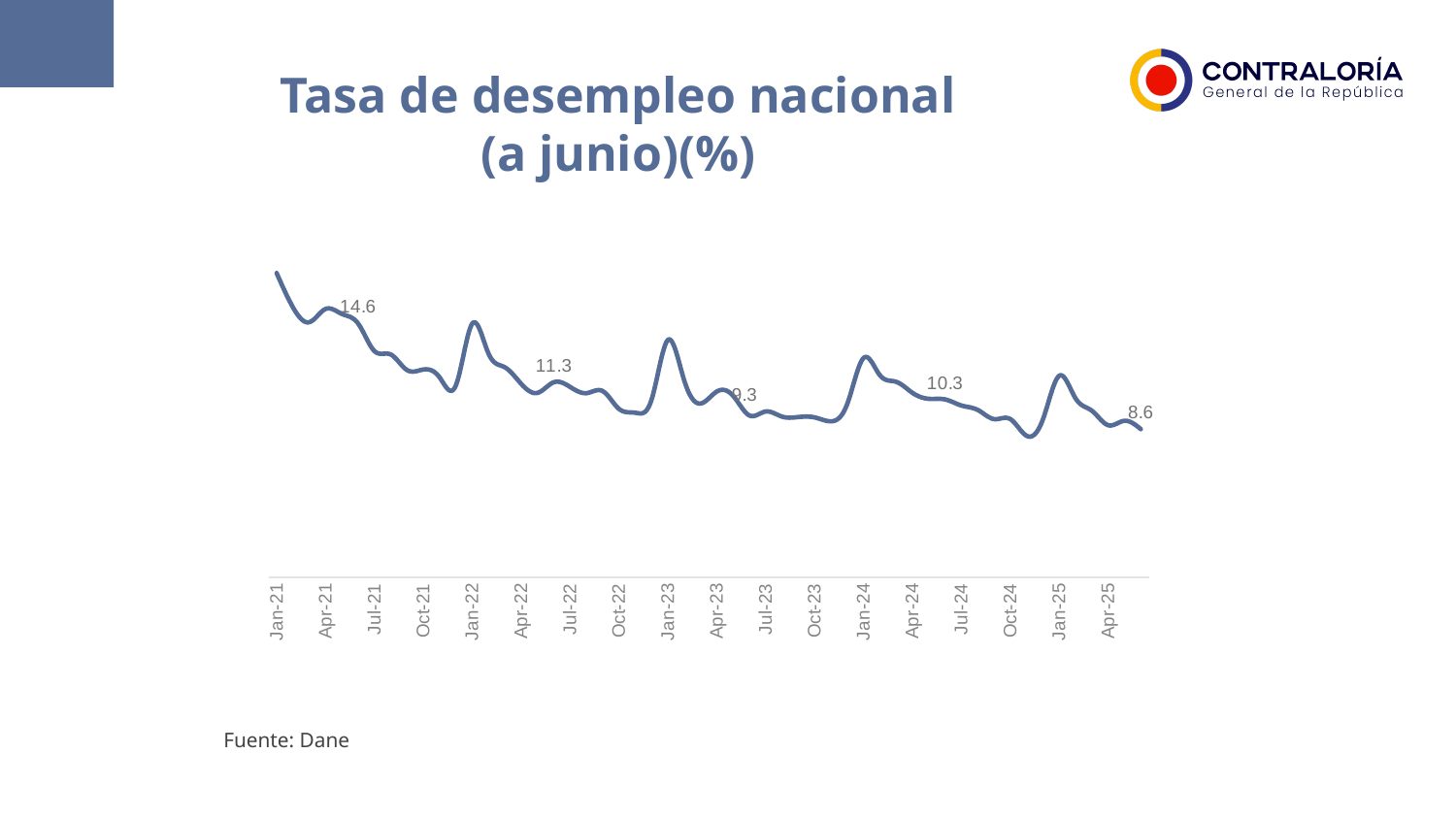
What is the data label shown on the line around mid-2024? 10.3 What type of chart is shown on the slide? line chart What is the title of the chart? Tasa de desempleo nacional (a junio)(%) What is the first data label shown on the line, around mid-2021? 14.6 Overall, does the unemployment rate rise or fall from Jan-21 to 2025? fall Which of the labeled values on the line is the lowest? 8.6 Which of the labeled values on the line is the highest? 14.6 What source is cited below the chart? Dane What is the data label shown on the line around mid-2022? 11.3 Which is larger, the labeled value around mid-2022 or the labeled value around mid-2024? mid-2022 (11.3) What is the difference between the first labeled value (14.6) and the last labeled value (8.6)? 6.0 What is the last data label shown at the end of the line, in 2025? 8.6